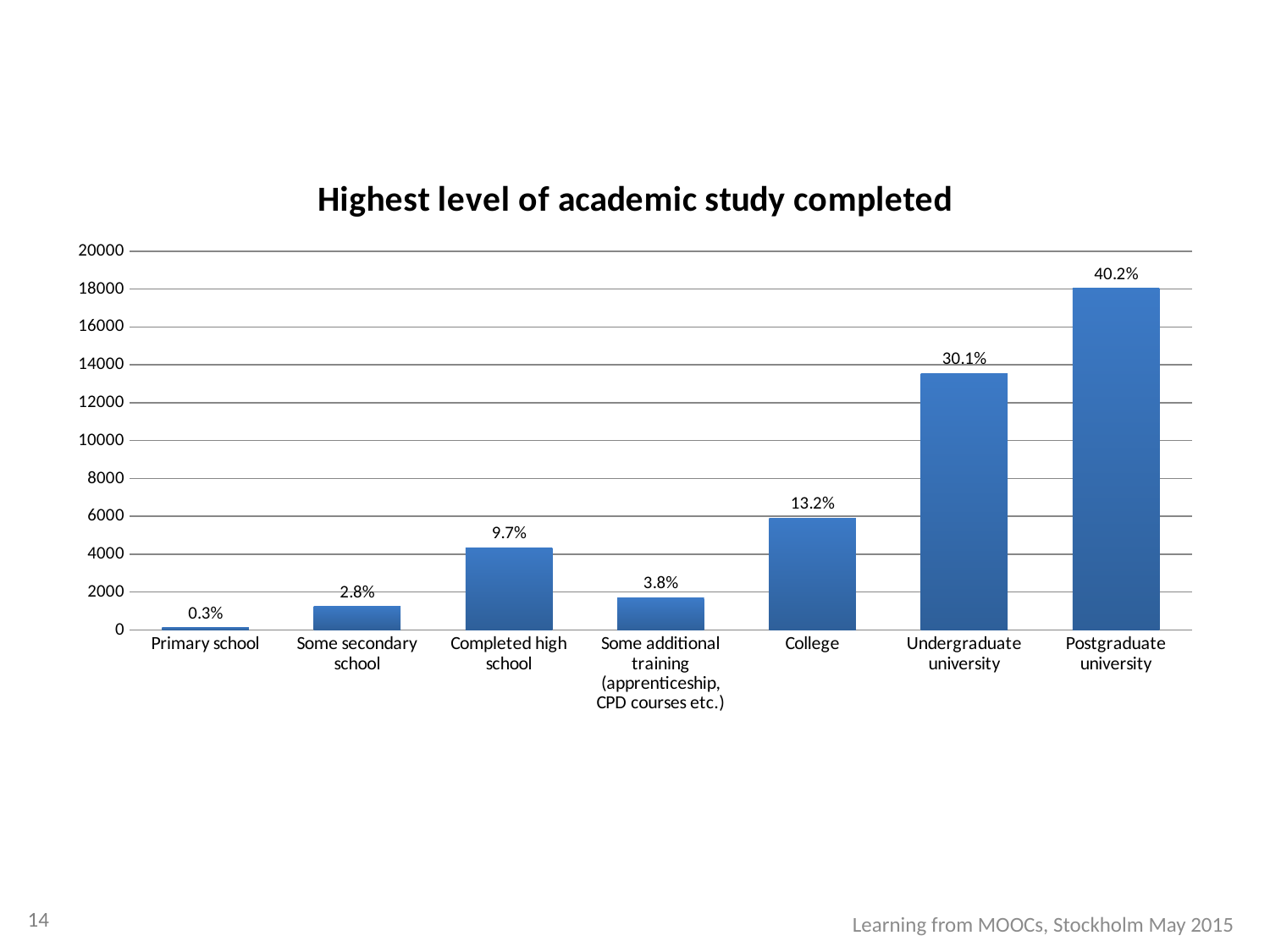
Is the value for Undergraduate university greater or less than 12000 on the y axis? greater What percentage label is shown on the College bar? 13.2% Which category has the lowest bar? Primary school What kind of chart is shown on the slide? Bar chart How many categories are shown on the x axis? 7 What percentage label is shown on the Some additional training (apprenticeship, CPD courses etc.) bar? 3.8% Which category has the highest bar? Postgraduate university Which is larger, the bar for Completed high school or the bar for Some additional training (apprenticeship, CPD courses etc.)? Completed high school What is the title of the chart? Highest level of academic study completed What percentage label is shown on the Postgraduate university bar? 40.2% Is the value for College greater or less than 8000 on the y axis? less What percentage label is shown on the Primary school bar? 0.3%